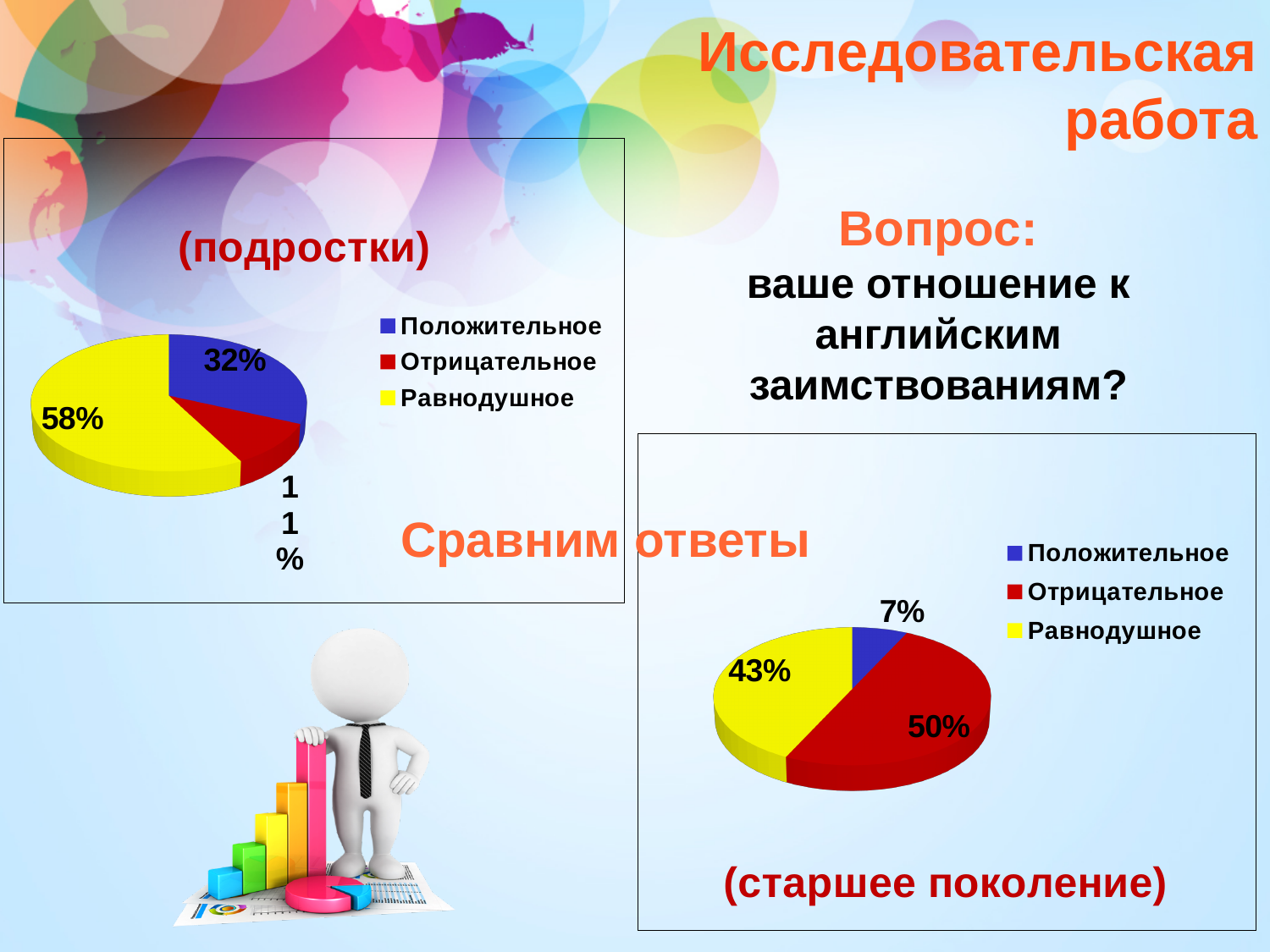
How many entries does the legend of the "(старшее поколение)" chart list? 3 In the "(старшее поколение)" chart, what is the difference between the Равнодушное and Положительное shares? 36% In the "(старшее поколение)" chart, which category has the largest slice? Отрицательное In the "(старшее поколение)" chart, what share is labelled for Положительное? 7% Which chart has the larger share for Положительное, "(подростки)" or "(старшее поколение)"? (подростки) In the "(подростки)" chart, which category has the smallest slice? Отрицательное In the "(подростки)" chart, what share is labelled for Отрицательное? 11% In the "(старшее поколение)" chart, what share is labelled for Отрицательное? 50% In the "(подростки)" chart, which category has the largest slice? Равнодушное In the "(подростки)" chart, what share is labelled for Равнодушное? 58% What kind of chart is the "(подростки)" chart? pie chart In the "(подростки)" chart, what share is labelled for Положительное? 32%